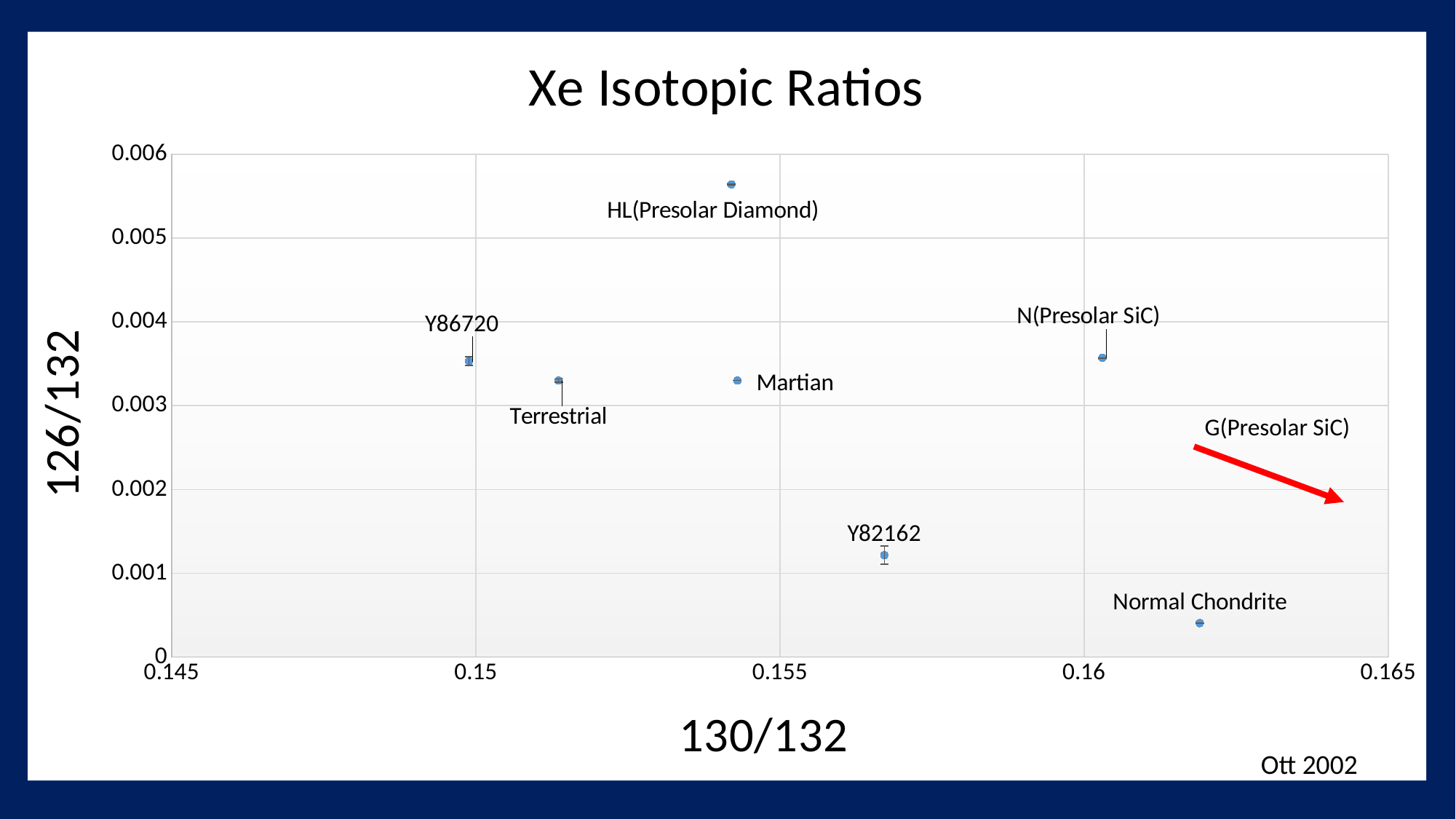
What is the label of the vertical axis? 126/132 Is the 126/132 value for HL(Presolar Diamond) greater or less than 0.005? greater What is the title of the chart? Xe Isotopic Ratios Which labeled point has the highest 126/132 value? HL(Presolar Diamond) Is the 130/132 value for Terrestrial greater or less than 0.15? greater Which has the larger 126/132 value, HL(Presolar Diamond) or N(Presolar SiC)? HL(Presolar Diamond) Which labeled point has the lowest 126/132 value? Normal Chondrite Which labeled point has the lowest 130/132 value? Y86720 What kind of chart is shown on the slide? Scatter chart Is the 126/132 value for Normal Chondrite greater or less than 0.001? less Which has the larger 126/132 value, Y82162 or Normal Chondrite? Y82162